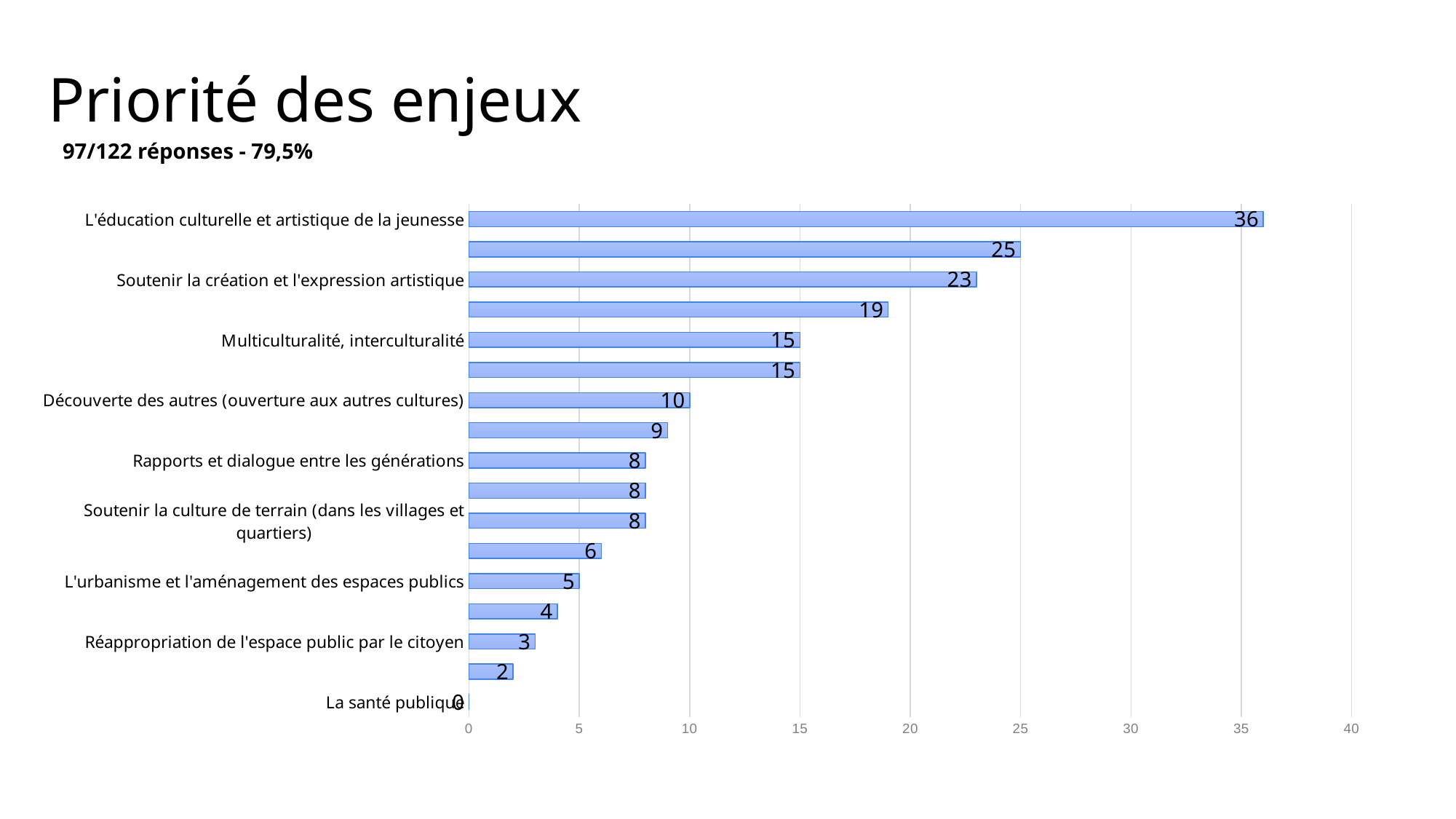
What is the value for "L'urbanisme et l'aménagement des espaces publics"? 5 How many bars are plotted in the chart? 17 What is the title of the slide? Priorité des enjeux What type of chart is shown on the slide? bar chart Which category has the lowest value? La santé publique What is the value for "L'éducation culturelle et artistique de la jeunesse"? 36 What is the difference between the values for "L'éducation culturelle et artistique de la jeunesse" and "Soutenir la création et l'expression artistique"? 13 Which category has the highest value? L'éducation culturelle et artistique de la jeunesse What is the value for "Découverte des autres (ouverture aux autres cultures)"? 10 What is the value for "Multiculturalité, interculturalité"? 15 Which is larger: the value for "Rapports et dialogue entre les générations" or the value for "Réappropriation de l'espace public par le citoyen"? Rapports et dialogue entre les générations What is the value for "Soutenir la création et l'expression artistique"? 23